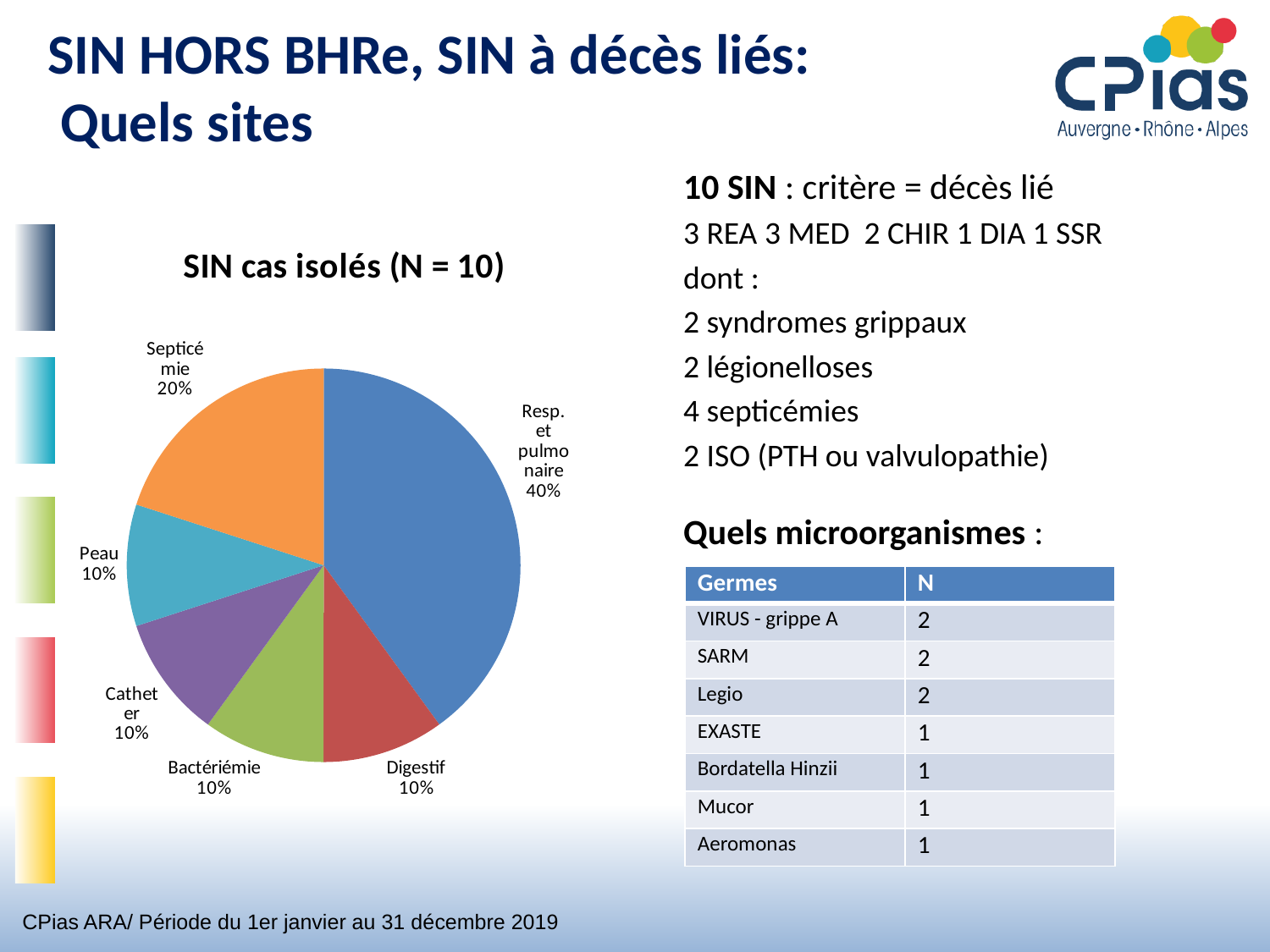
What colour is the Resp. et pulmonaire slice? blue What type of chart is shown on the slide? pie chart Which category has the largest slice of the pie? Resp. et pulmonaire What share of the pie does Septicémie represent? 20% What is the value shown for Digestif? 10% What is the difference between the Resp. et pulmonaire share and the Septicémie share? 20% What is the value shown for Peau? 10% What is the title of the chart? SIN cas isolés (N = 10) What share of the pie does Resp. et pulmonaire represent? 40% Which is larger, the Septicémie slice or the Bactériémie slice? Septicémie What is the combined share of Cathéter and Peau? 20% How many slices does the pie chart have? 6